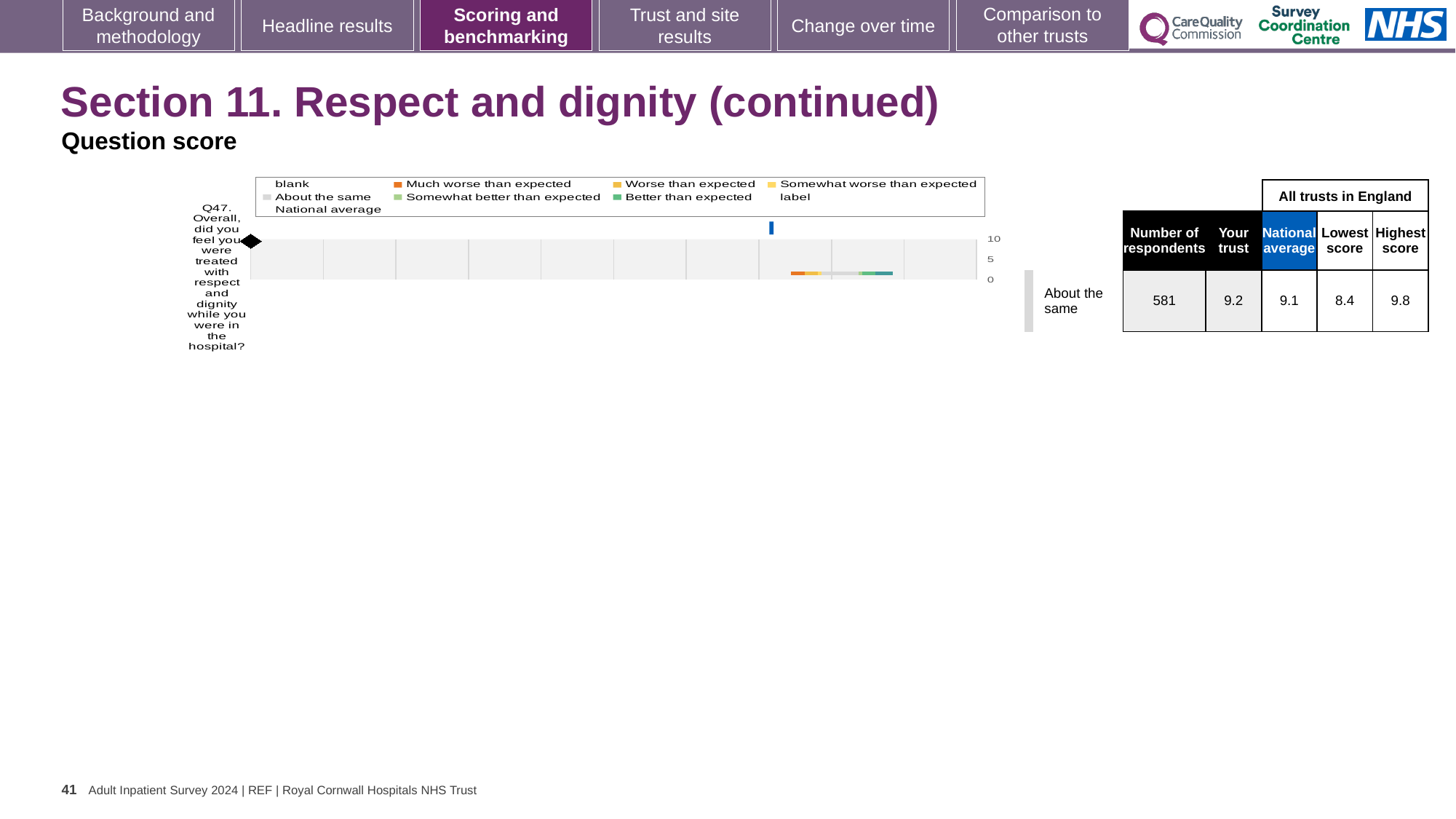
What kind of chart is used to show the Q47 question score? bar chart How many survey questions are plotted on the chart? 1 What is the 'Your trust' score for Q47 (treated with respect and dignity)? 9.2 How many respondents answered Q47? 581 What is the lowest score among all trusts in England for Q47? 8.4 What is the national average score for Q47? 9.1 By how much does the 'Your trust' score for Q47 exceed the national average? 0.1 What colour represents 'Much worse than expected' in the chart legend? orange What is the difference between the highest and lowest scores for Q47 across all trusts in England? 1.4 What is the highest score among all trusts in England for Q47? 9.8 Which is higher for Q47, the 'Your trust' score or the national average? Your trust Which benchmark category is Q47 assigned to on the chart? About the same